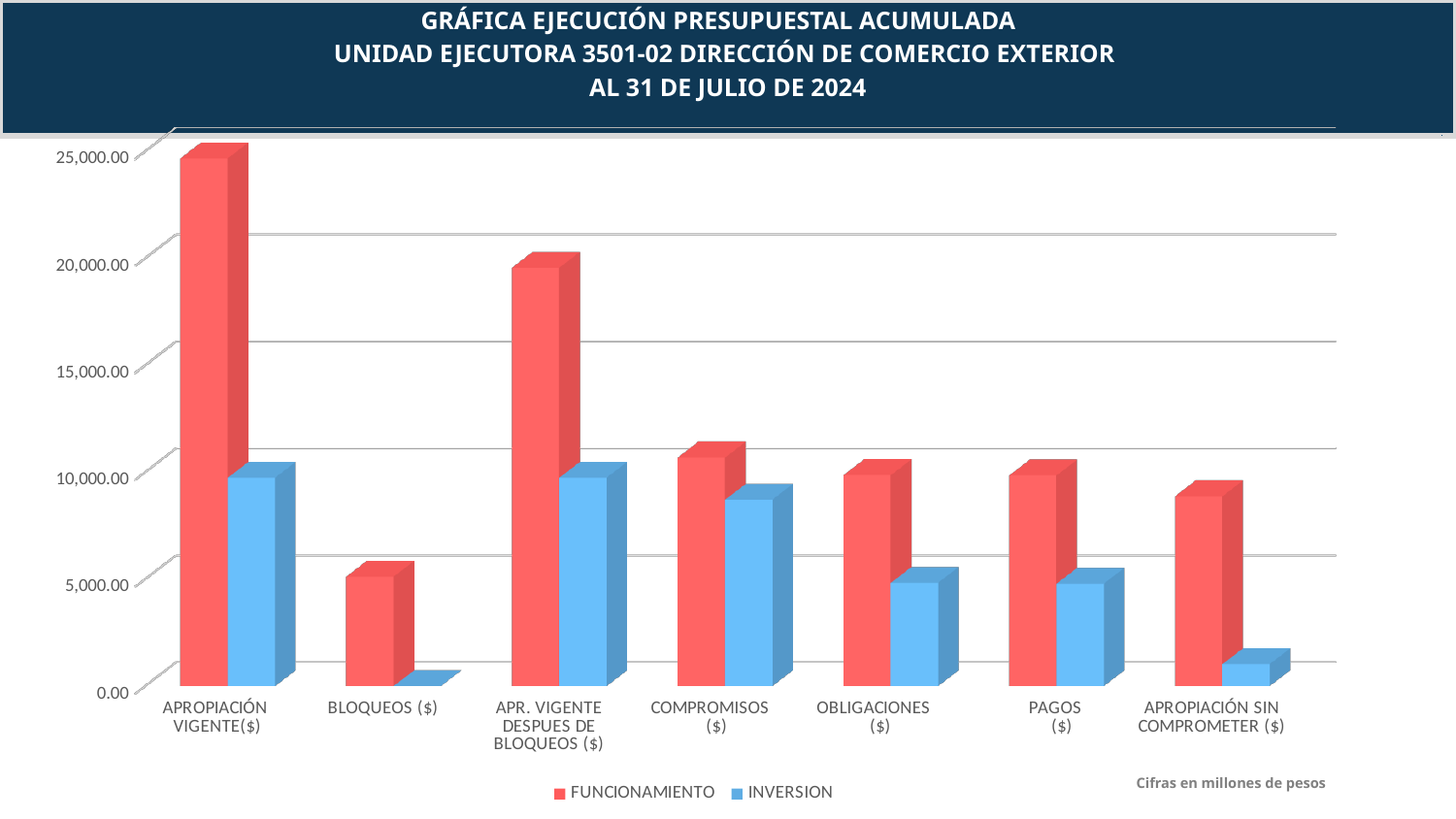
Which colour represents the INVERSION series in the legend? Blue According to the note on the slide, in what units are the figures expressed? Millones de pesos What kind of chart is shown on the slide? Bar chart Is the FUNCIONAMIENTO value for BLOQUEOS ($) greater or less than 10,000.00? less Which category has the lowest INVERSION value? BLOQUEOS ($) Is the INVERSION value for APROPIACIÓN SIN COMPROMETER ($) greater or less than 5,000.00? less Which category has the highest FUNCIONAMIENTO value? APROPIACIÓN VIGENTE($) How many categories are shown on the x axis? 7 Is the FUNCIONAMIENTO value for APR. VIGENTE DESPUES DE BLOQUEOS ($) greater or less than 15,000.00? greater For APROPIACIÓN VIGENTE($), which series is larger, FUNCIONAMIENTO or INVERSION? FUNCIONAMIENTO How many series does the legend list? 2